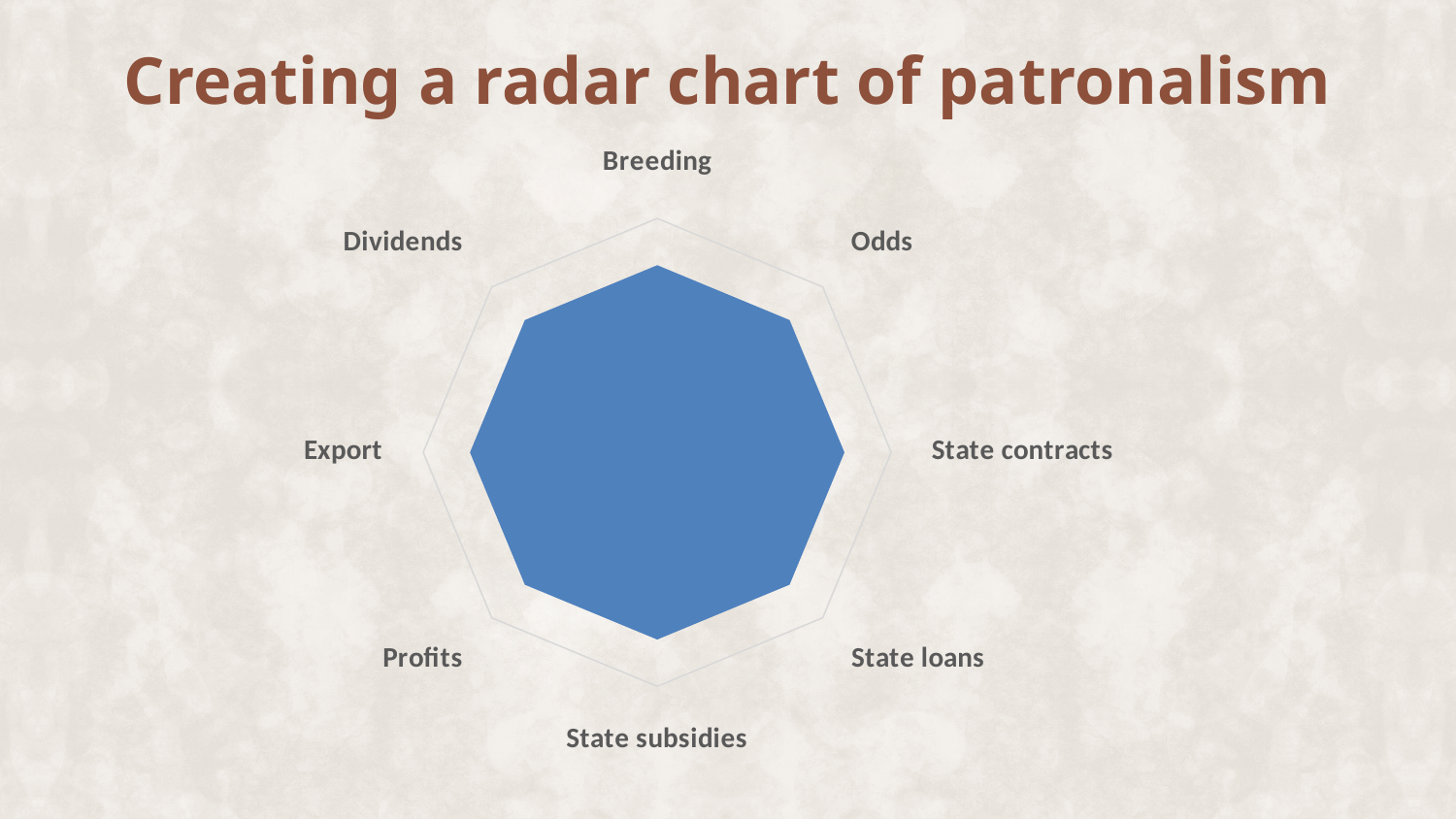
Which category label appears at the bottom of the radar chart? State subsidies How many categories (axes) does the radar chart have? 8 Which category label appears at the top of the radar chart? Breeding Which category label sits between Breeding and State contracts on the radar chart? Odds What colour is the filled area of the radar chart? Blue Which category label sits between State contracts and State subsidies on the radar chart? State loans Which category label is on the far left of the radar chart? Export What kind of chart is shown on the slide? Radar chart Which category label sits between Export and State subsidies on the radar chart? Profits Which category label is on the far right of the radar chart? State contracts What is the title of the slide containing the radar chart? Creating a radar chart of patronalism Which category label sits between Export and Breeding on the radar chart? Dividends